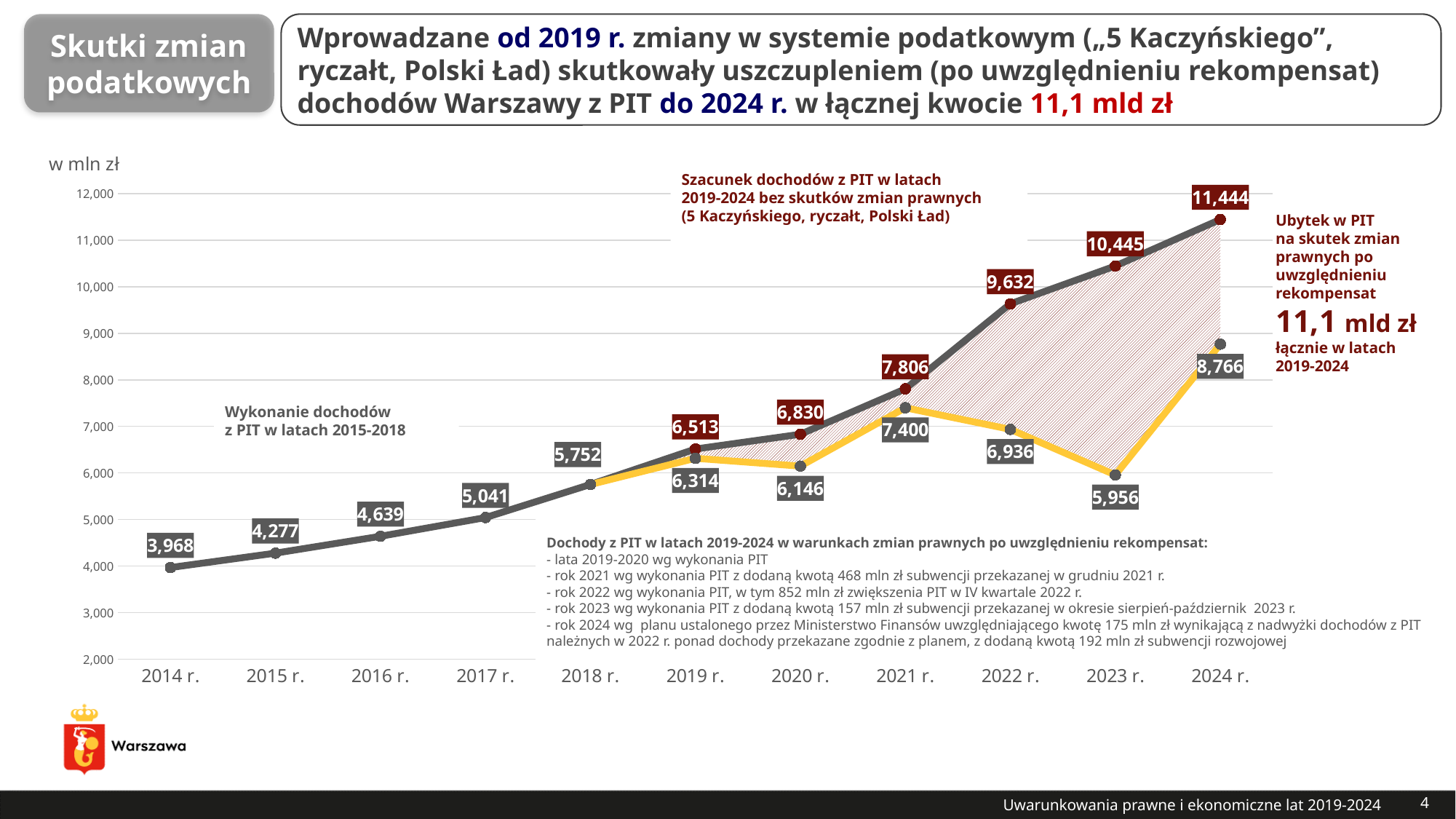
Which is larger: the actual PIT revenue for 2021 r. or for 2022 r.? 2021 r. What is the difference between the estimated value without legal changes and the actual value for 2024 r.? 2,678 What is the PIT revenue value shown for 2014 r.? 3,968 What type of chart is shown on the slide? line chart What is the actual PIT revenue (lower, yellow line) for 2023 r.? 5,956 How many years are shown on the x axis? 11 What is the actual PIT revenue (lower, yellow line) for 2021 r.? 7,400 Which year has the highest value on the upper (estimate) line? 2024 r. Which year has the lowest value on the chart? 2014 r. What is the difference between the estimated value without legal changes and the actual value for 2022 r.? 2,696 What is the estimated PIT revenue without legal changes (upper line) for 2024 r.? 11,444 What unit is stated for the values on the chart? w mln zł